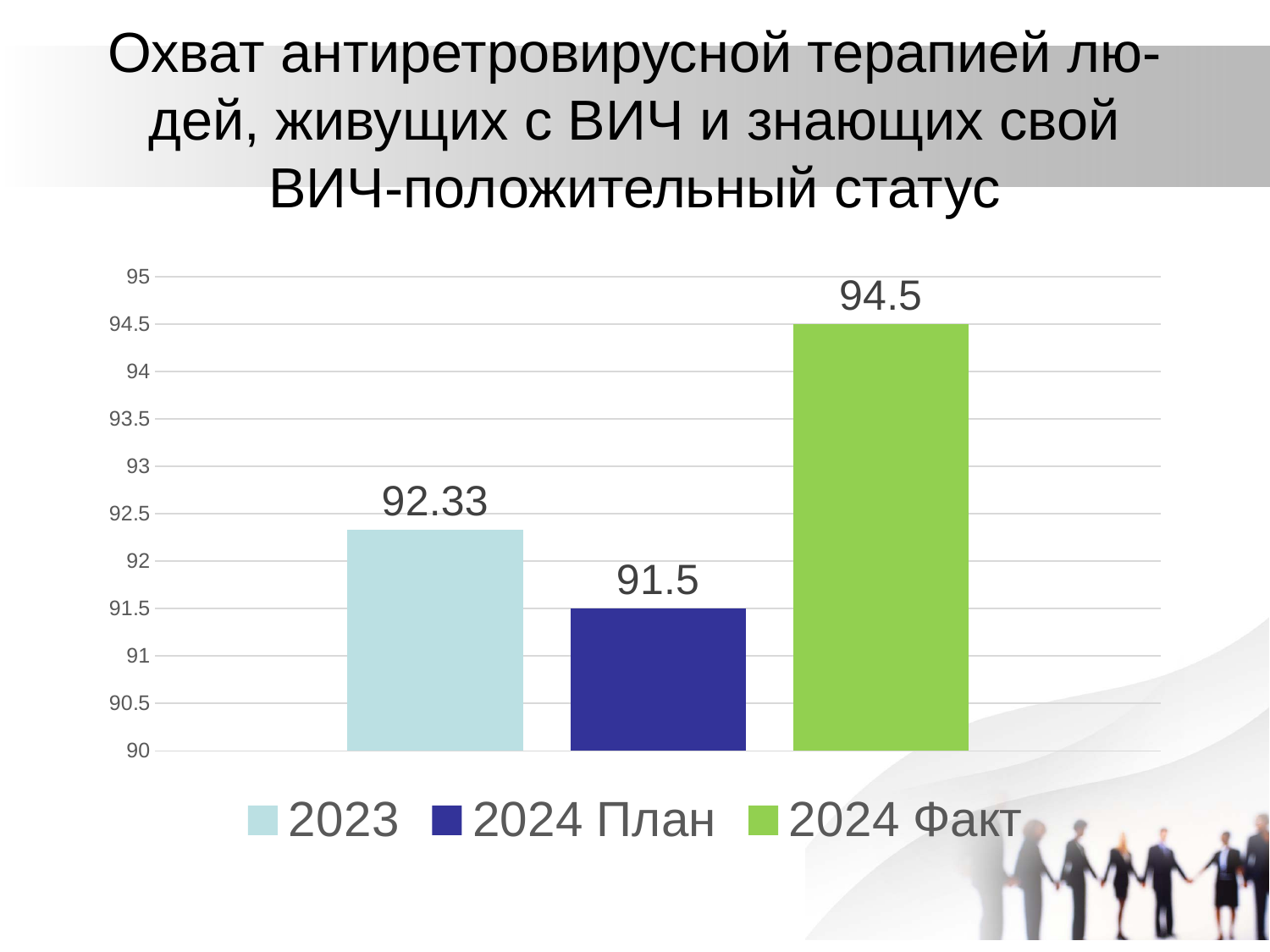
What kind of chart is shown on the slide? bar chart Which is larger, the value for 2023 or the value for 2024 Факт? 2024 Факт Which series has the lowest value? 2024 План Is the value for 2023 greater or less than 92? greater How many series does the legend list? 3 What is the difference between the 2023 value and the 2024 План value? 0.83 How many bars are plotted on the chart? 3 What is the value for 2024 Факт? 94.5 What is the difference between the 2024 Факт value and the 2024 План value? 3 What is the value for 2024 План? 91.5 Which series has the highest value? 2024 Факт What is the value for 2023? 92.33